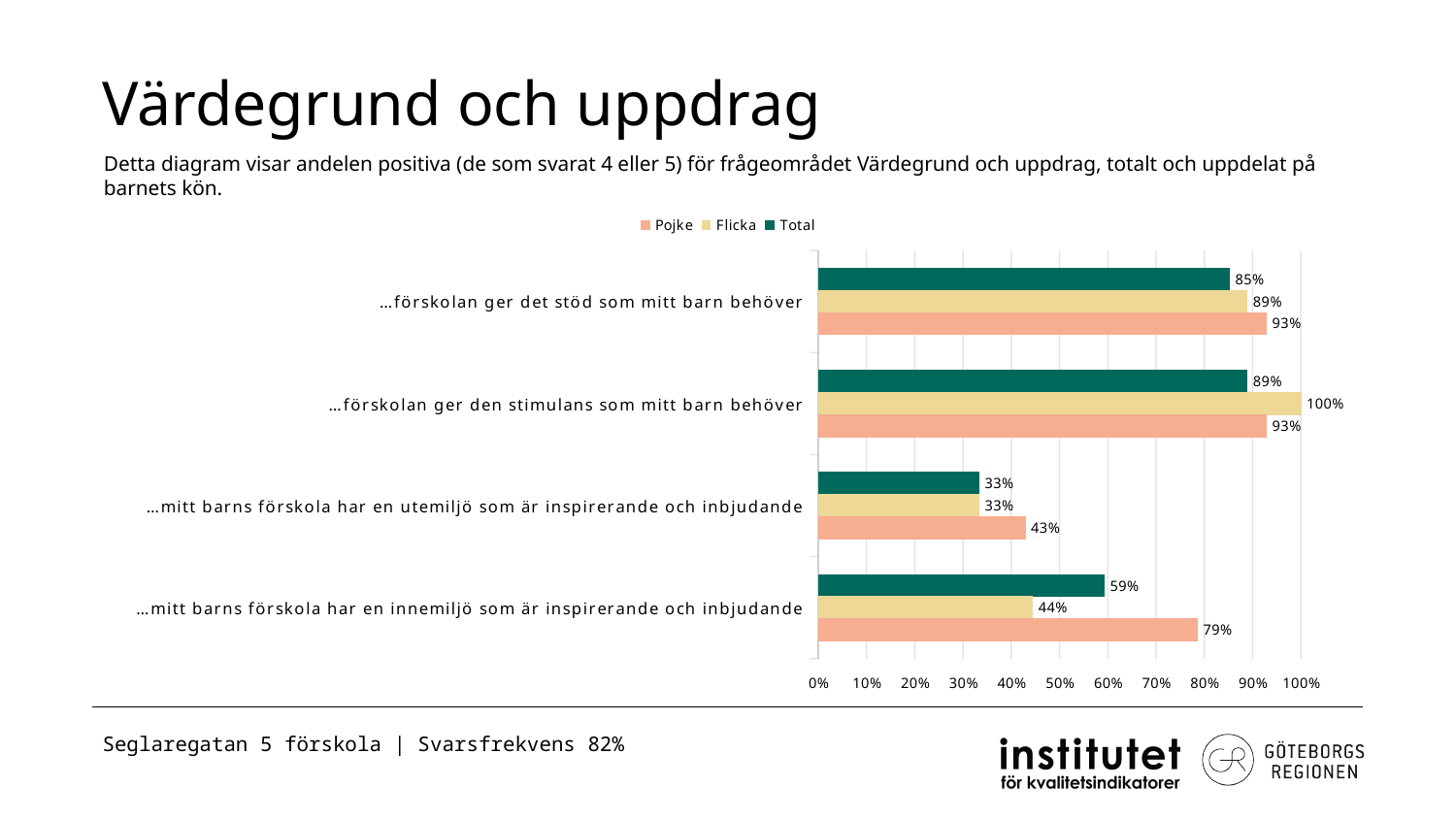
Which series is shown in dark green in the legend? Total How many series does the legend list? 3 How many categories are shown on the chart? 4 What is the Total value for "…förskolan ger det stöd som mitt barn behöver"? 85% What is the Pojke value for "…mitt barns förskola har en innemiljö som är inspirerande och inbjudande"? 79% Which category has the highest Flicka value? …förskolan ger den stimulans som mitt barn behöver What is the Flicka value for "…förskolan ger den stimulans som mitt barn behöver"? 100% What is the difference between the Pojke and Flicka values for "…mitt barns förskola har en innemiljö som är inspirerande och inbjudande"? 35% What kind of chart is shown on the slide? Bar chart What is the Flicka value for "…mitt barns förskola har en utemiljö som är inspirerande och inbjudande"? 33% For "…förskolan ger det stöd som mitt barn behöver", which is larger, the Pojke value or the Flicka value? Pojke Which category has the lowest Total value? …mitt barns förskola har en utemiljö som är inspirerande och inbjudande